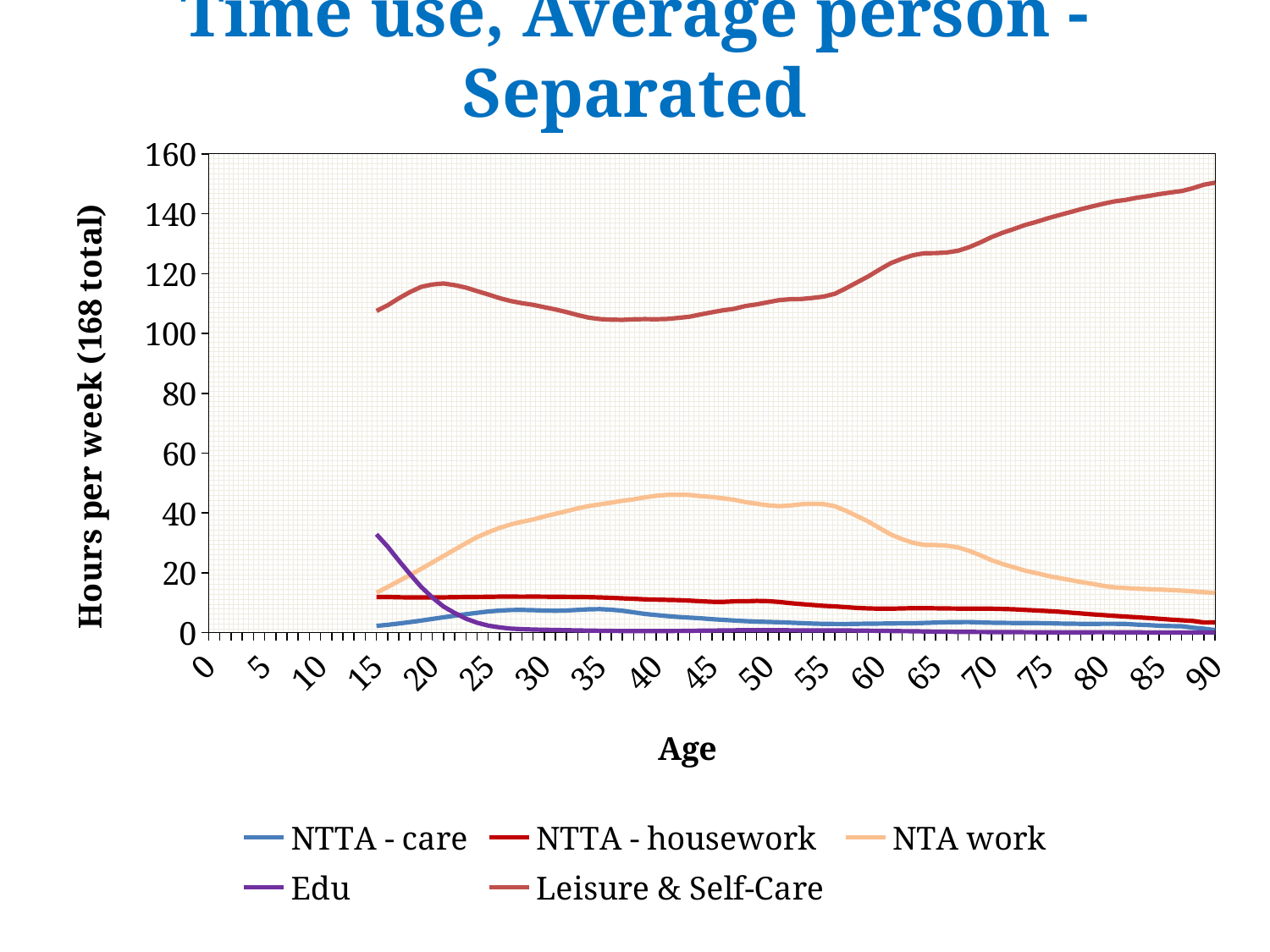
What is the label on the vertical axis? Hours per week (168 total) Does the Leisure & Self-Care line rise or fall between age 60 and age 90? rise Is the value for NTA work at age 40 greater or less than 40? greater Is the value for NTA work at age 90 greater or less than 20? less How many series does the legend list? 5 What kind of chart is shown on the slide? line chart Is the value for Leisure & Self-Care at age 90 greater or less than 140? greater Which series has the highest values across all ages? Leisure & Self-Care Does the NTA work line rise or fall between age 55 and age 90? fall At age 60, which is larger: NTA work or NTTA - housework? NTA work